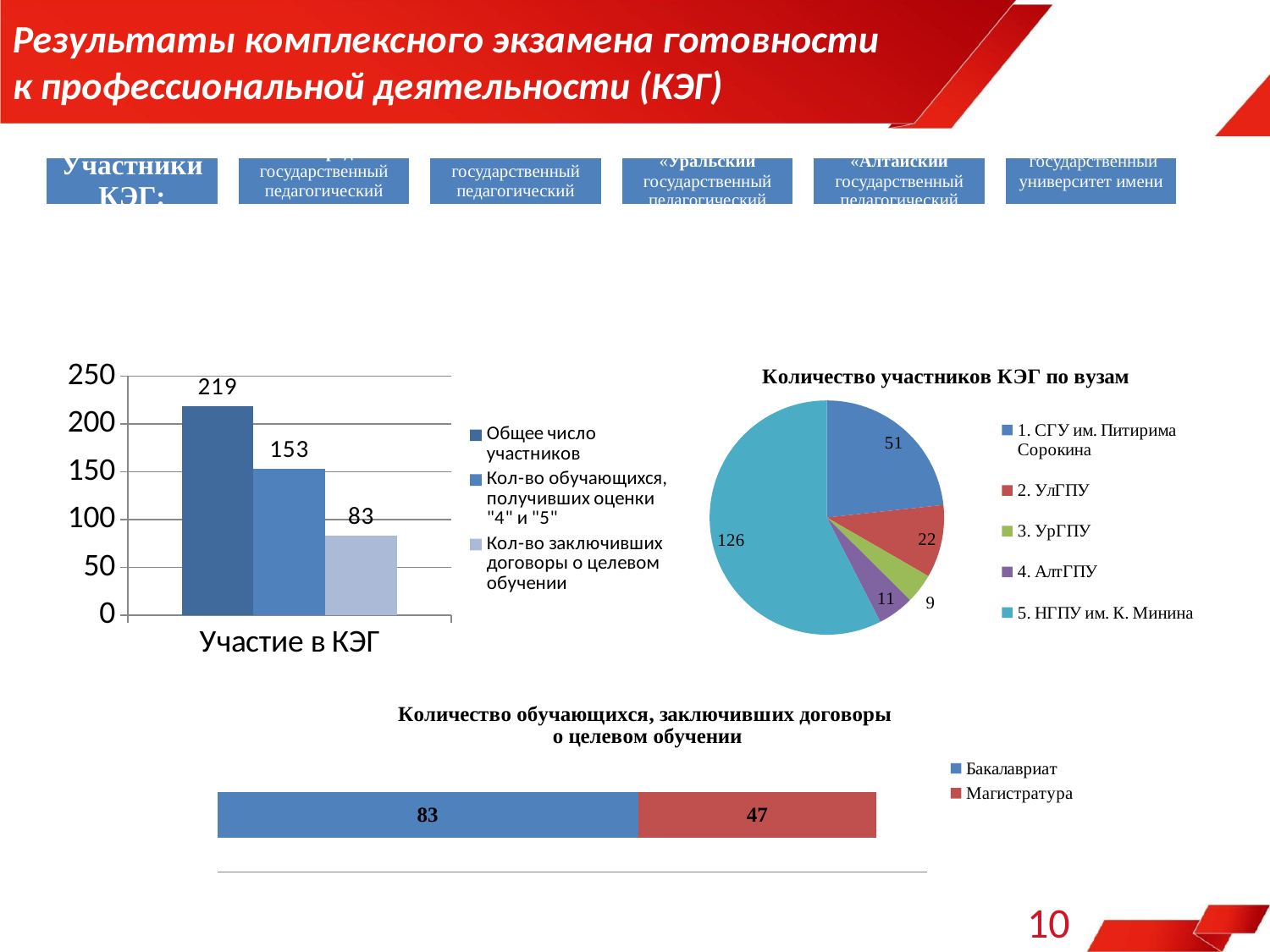
In the bar chart on the left (Участие в КЭГ), how many series does the legend list? 3 In the bottom chart Количество обучающихся, заключивших договоры о целевом обучении, what is the value for Магистратура? 47 What kind of chart is the chart on the left titled Участие в КЭГ? bar chart In the pie chart Количество участников КЭГ по вузам, which university has the smallest slice? 3. УрГПУ In the pie chart Количество участников КЭГ по вузам, what is the value for 2. УлГПУ? 22 In the bar chart on the left (Участие в КЭГ), what is the value for Общее число участников? 219 In the pie chart Количество участников КЭГ по вузам, which university has the largest slice? 5. НГПУ им. К. Минина In the pie chart Количество участников КЭГ по вузам, how many universities are shown? 5 In the bar chart on the left (Участие в КЭГ), what is the value for Кол-во заключивших договоры о целевом обучении? 83 In the bottom chart Количество обучающихся, заключивших договоры о целевом обучении, what is the total of the stacked bar? 130 In the bar chart on the left (Участие в КЭГ), what is the difference between Общее число участников and Кол-во обучающихся, получивших оценки "4" и "5"? 66 In the pie chart Количество участников КЭГ по вузам, which is larger: 1. СГУ им. Питирима Сорокина or 4. АлтГПУ? 1. СГУ им. Питирима Сорокина